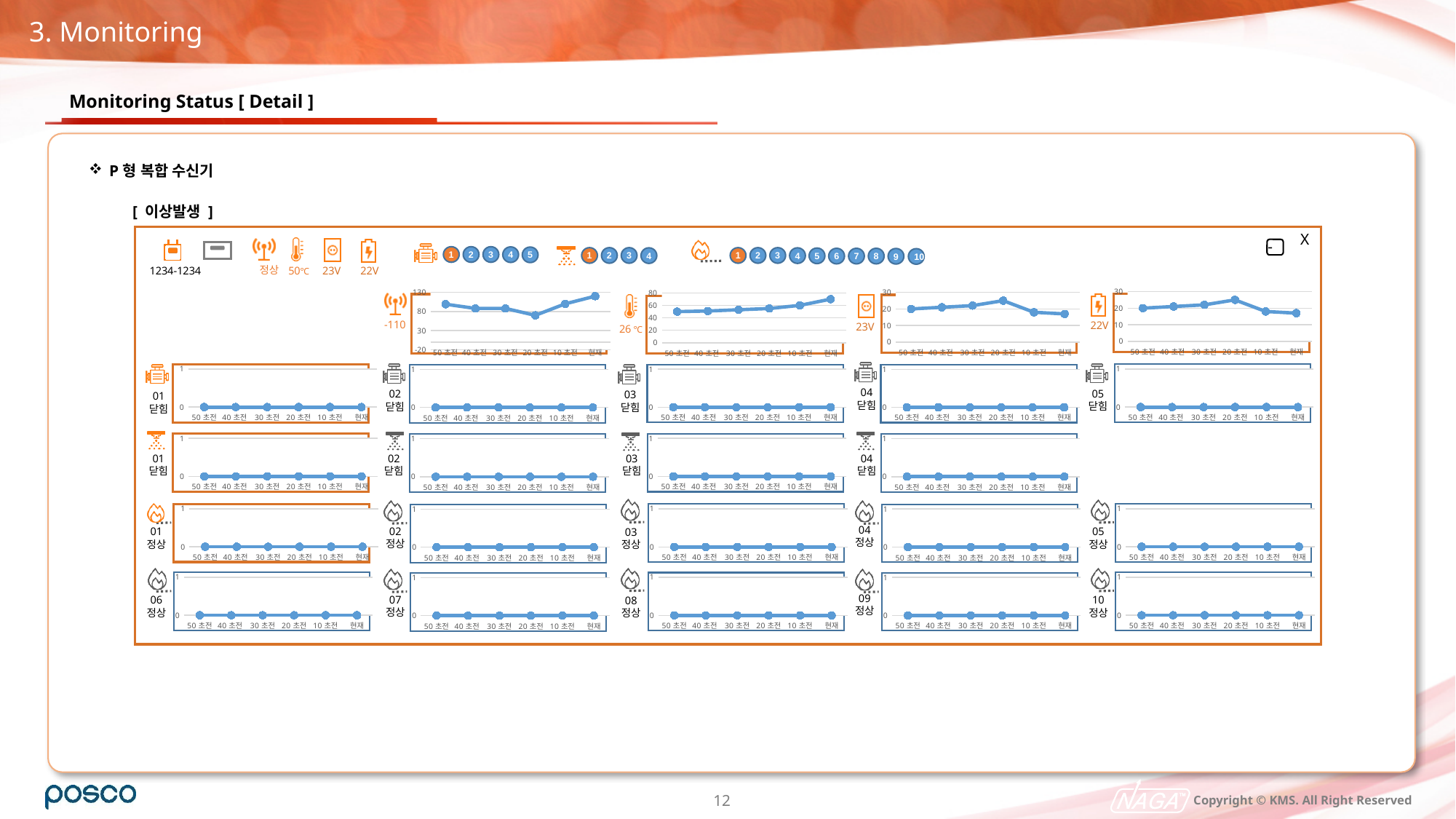
In the temperature chart (labelled 26 ℃), which time point has the highest value? 현재 What is the highest tick shown on the y axis of the signal-strength chart (labelled -110)? 130 How many time points are plotted along the x axis of the signal-strength chart (labelled -110) at the top left? 6 In the signal-strength chart (labelled -110), which time point has the lowest value? 20 초전 In the chart for sensor 01 닫힘 (first chart in the second row of the grid), do the values rise, fall, or stay flat across the x axis? stay flat In the signal-strength chart (labelled -110), is the value at 현재 greater or less than 80? greater What kind of chart is the temperature chart (labelled 26 ℃) at the top of the dashboard? line chart In the temperature chart (labelled 26 ℃), is the value at 현재 greater or less than 60? greater In the 23V voltage chart at the top, which time point has the highest value? 20 초전 In the signal-strength chart (labelled -110), which is larger: the value at 현재 or the value at 50 초전? 현재 In the 22V voltage chart at the top right, is the value at 20 초전 greater or less than 20? greater In the temperature chart (labelled 26 ℃), do the values generally rise or fall from 50 초전 to 현재? rise